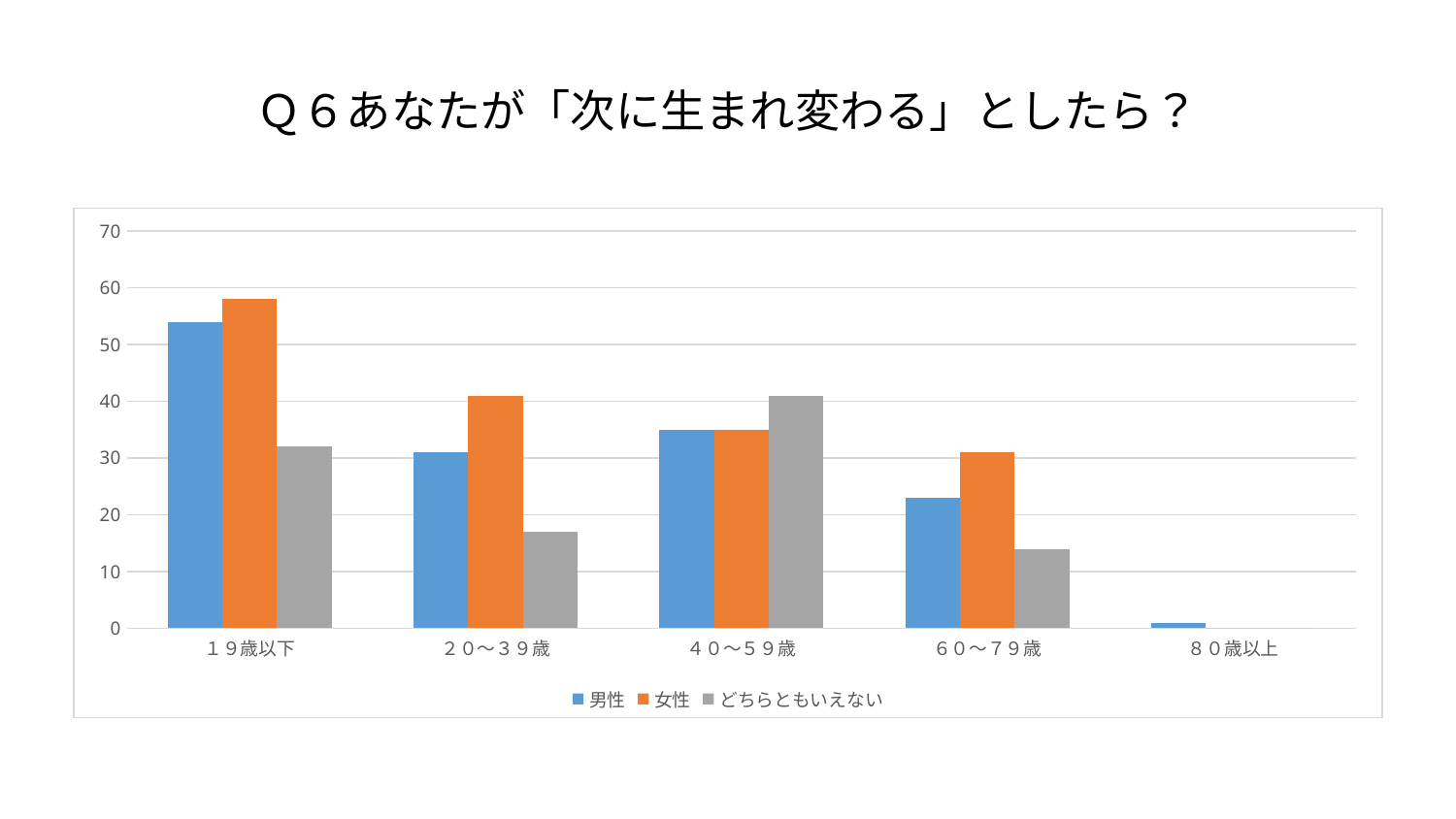
Is the value for どちらともいえない in the ２０〜３９歳 category greater or less than 20? less Which is larger in the ４０〜５９歳 category, 男性 or どちらともいえない? どちらともいえない Which age category has the lowest value for 男性? ８０歳以上 How many series does the legend list? 3 How many age categories are shown on the x axis? 5 Which is larger in the ２０〜３９歳 category, 男性 or 女性? 女性 What kind of chart is shown on the slide? bar chart Which age category has the highest value for 女性? １９歳以下 Do the values for 女性 generally rise or fall from １９歳以下 to ８０歳以上? fall What colour are the bars for 女性? orange Is the value for 男性 in the １９歳以下 category greater or less than 50? greater